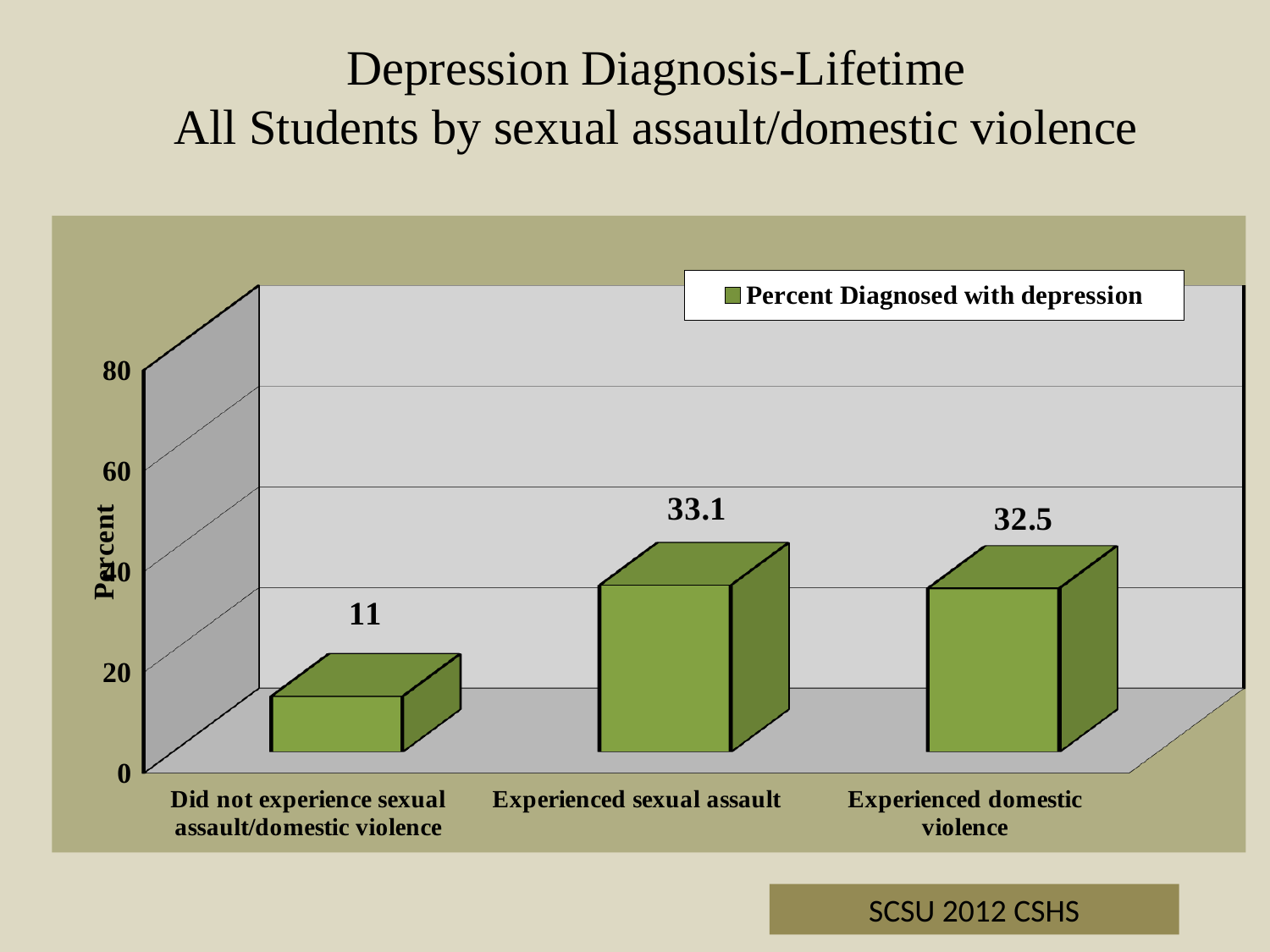
Which category has the lowest percent diagnosed with depression? Did not experience sexual assault/domestic violence What is the percent diagnosed with depression for students who experienced sexual assault? 33.1 What is the difference in percent diagnosed with depression between students who experienced sexual assault and those who experienced domestic violence? 0.6 How many categories are shown on the x axis? 3 How many series does the legend list? 1 Is the value for students who did not experience sexual assault/domestic violence greater or less than 20? less What is the difference in percent diagnosed with depression between students who experienced sexual assault and those who did not experience sexual assault/domestic violence? 22.1 Which category has the highest percent diagnosed with depression? Experienced sexual assault What kind of chart is shown on the slide? Bar chart Which is larger: the percent diagnosed with depression for students who experienced domestic violence or for students who did not experience sexual assault/domestic violence? Experienced domestic violence What is the percent diagnosed with depression for students who did not experience sexual assault/domestic violence? 11 What is the percent diagnosed with depression for students who experienced domestic violence? 32.5